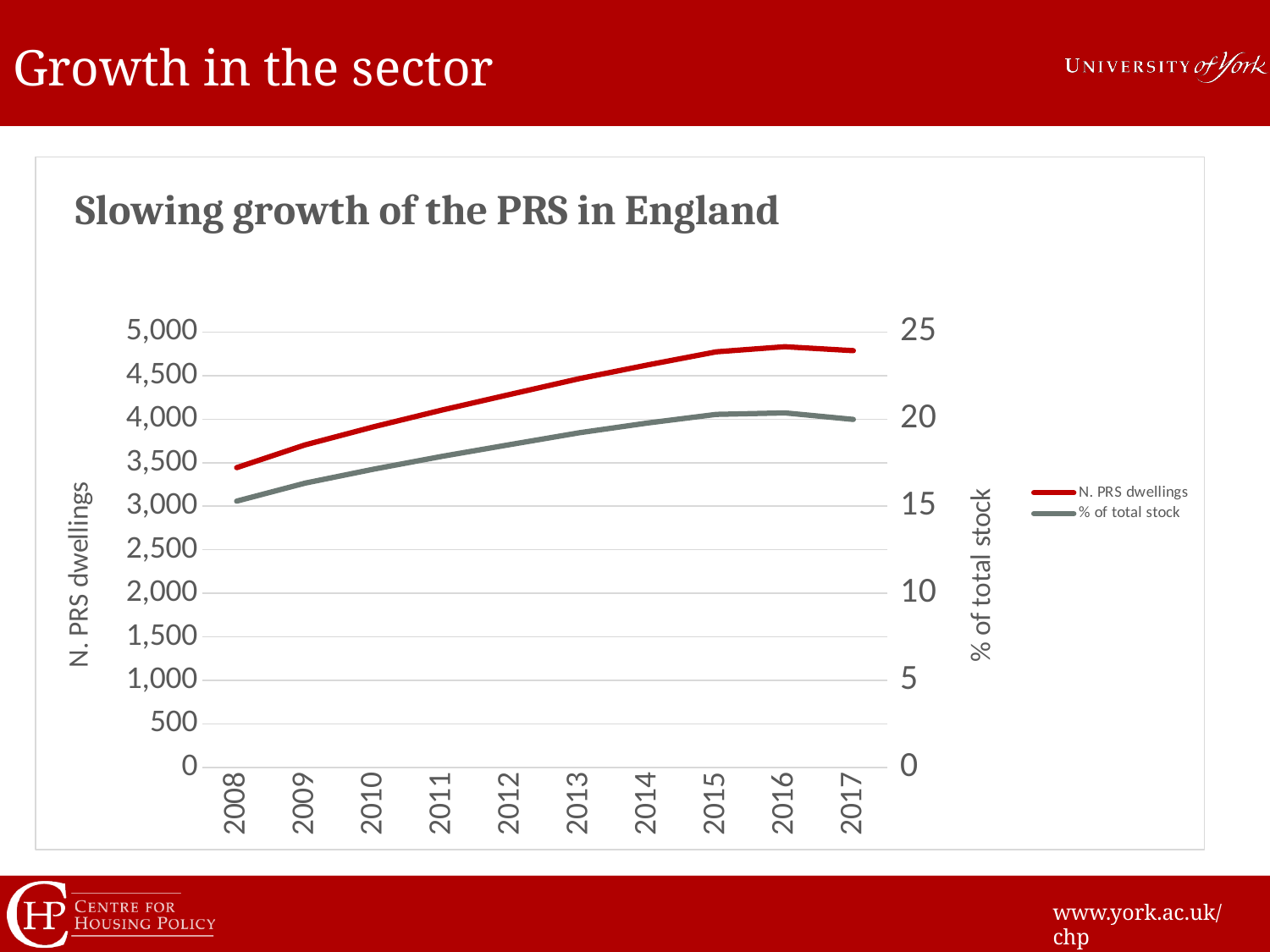
Which is larger, the value for N. PRS dwellings in 2010 or in 2015? 2015 In which year is the value for N. PRS dwellings lowest? 2008 Is the value for N. PRS dwellings in 2017 greater or less than 4,500? greater How many series does the legend list? 2 Is the value for % of total stock in 2012 greater or less than 20? less How many years are plotted along the x axis? 10 What is the title of the chart? Slowing growth of the PRS in England Is the value for N. PRS dwellings in 2008 greater or less than 3,000? greater What kind of chart is shown on the slide? line chart What colour is the line for N. PRS dwellings? red Does the % of total stock line generally rise or fall from 2008 to 2015? rise